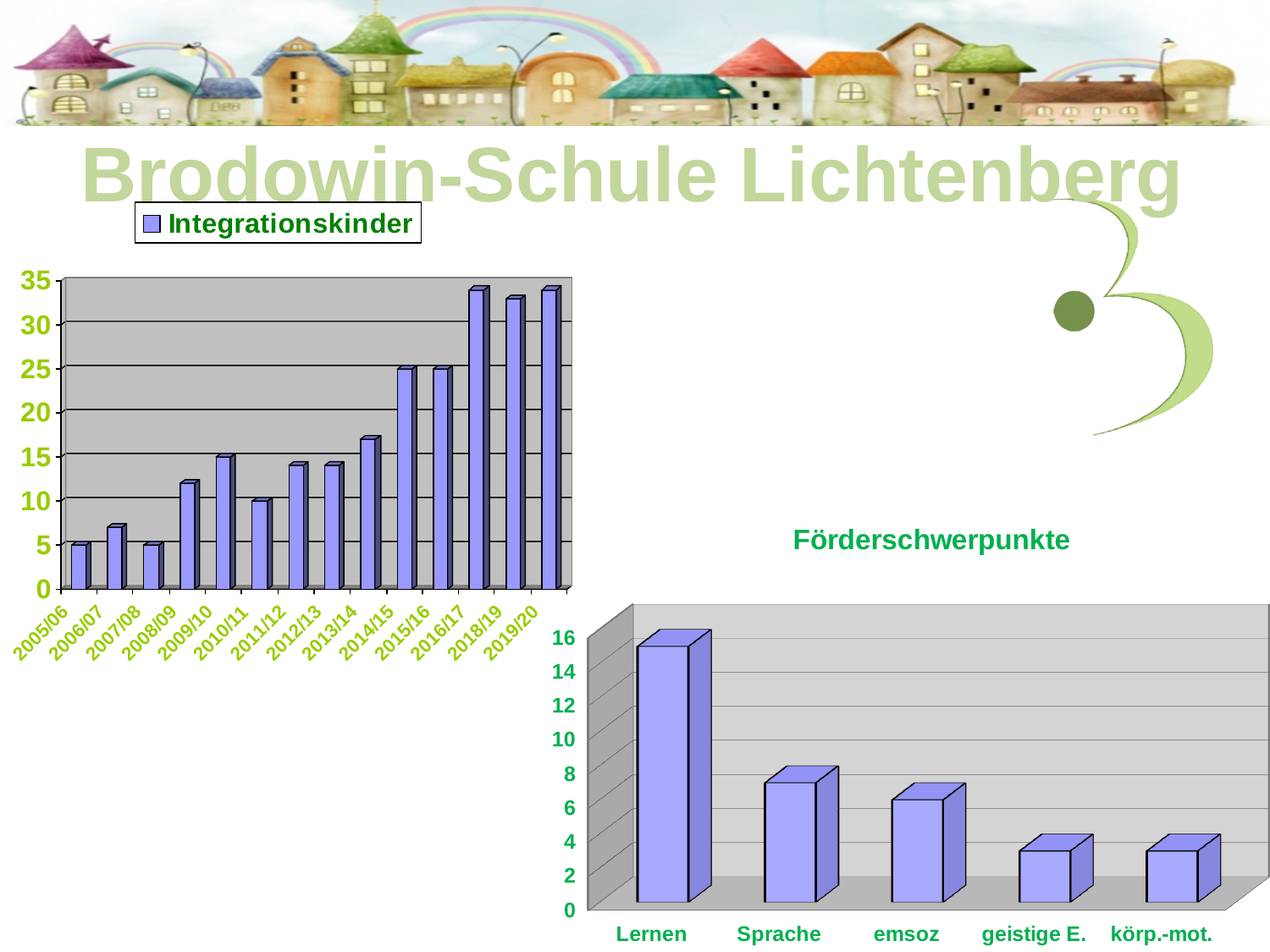
In the Förderschwerpunkte chart, which category has the highest value? Lernen In the Förderschwerpunkte chart, is the value for Lernen greater or less than 14? greater In the Integrationskinder chart, is the value for 2005/06 greater or less than 10? less In the Integrationskinder chart, is the value for 2016/17 greater or less than 30? greater What kind of chart is the Integrationskinder chart on the left? bar chart How many series does the legend of the Integrationskinder chart list? 1 In the Integrationskinder chart, which is larger, the value for 2009/10 or for 2010/11? 2009/10 In the Integrationskinder chart, do the values generally rise or fall from 2005/06 to 2019/20? rise How many school years are shown on the x axis of the Integrationskinder chart? 14 How many categories are shown in the Förderschwerpunkte chart? 5